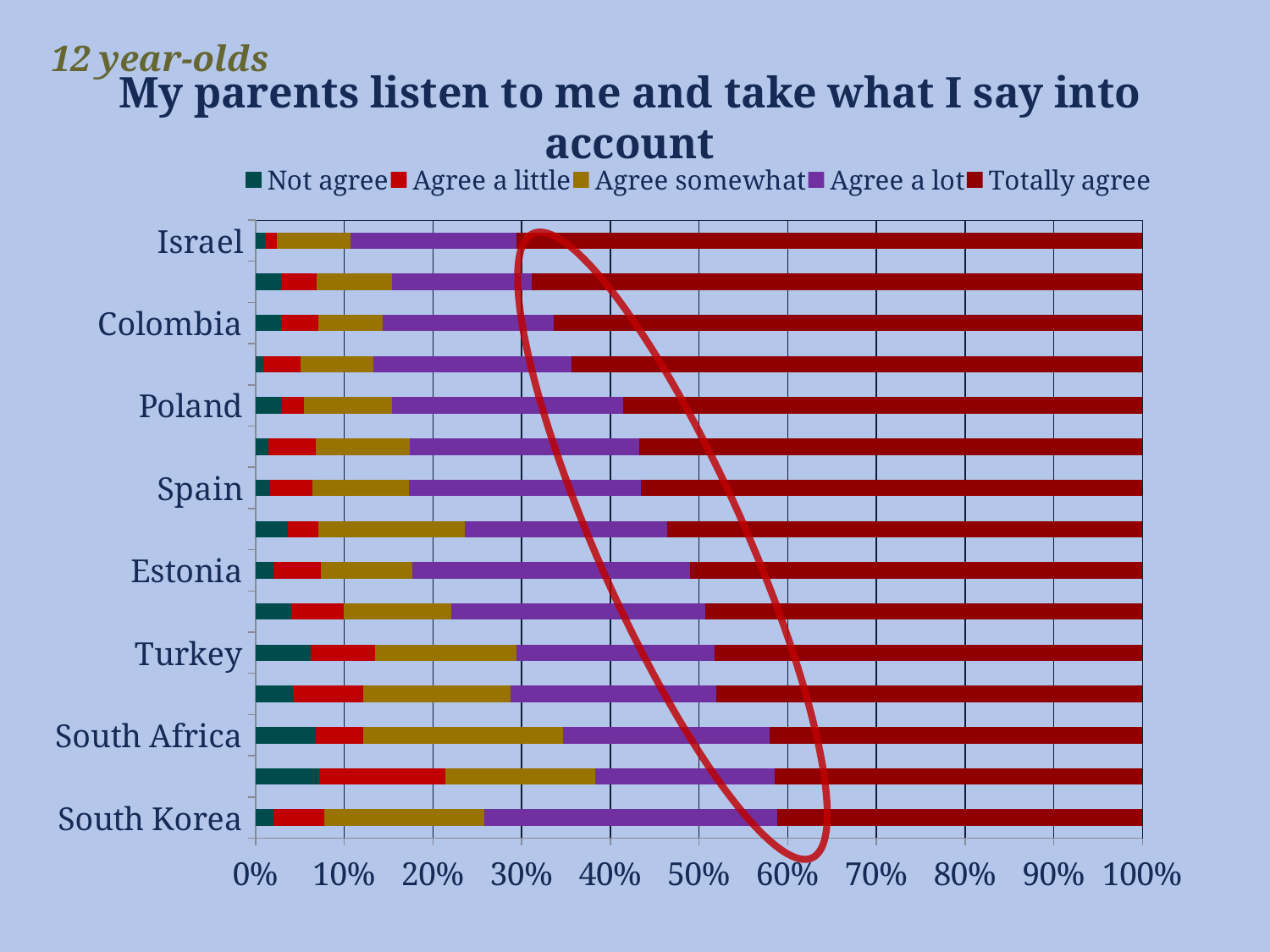
For South Korea, is the combined share of all responses other than 'Totally agree' greater or less than 50%? greater How many bars are plotted in the chart? 15 Moving down the chart from Israel at the top to South Korea at the bottom, does the 'Totally agree' share increase or decrease? decrease Which age group does the chart refer to, according to the slide? 12 year-olds Is the 'Totally agree' share larger for Colombia or for Turkey? Colombia For Israel, is the combined share of all responses other than 'Totally agree' greater or less than 40%? less What is the title of the chart? My parents listen to me and take what I say into account Is the 'Totally agree' share larger for Israel or for South Korea? Israel Which of the labelled countries has the largest 'Totally agree' share? Israel How many series does the legend list? 5 For Turkey, is the combined share of all responses other than 'Totally agree' greater or less than 40%? greater What kind of chart is shown on the slide? Stacked bar chart